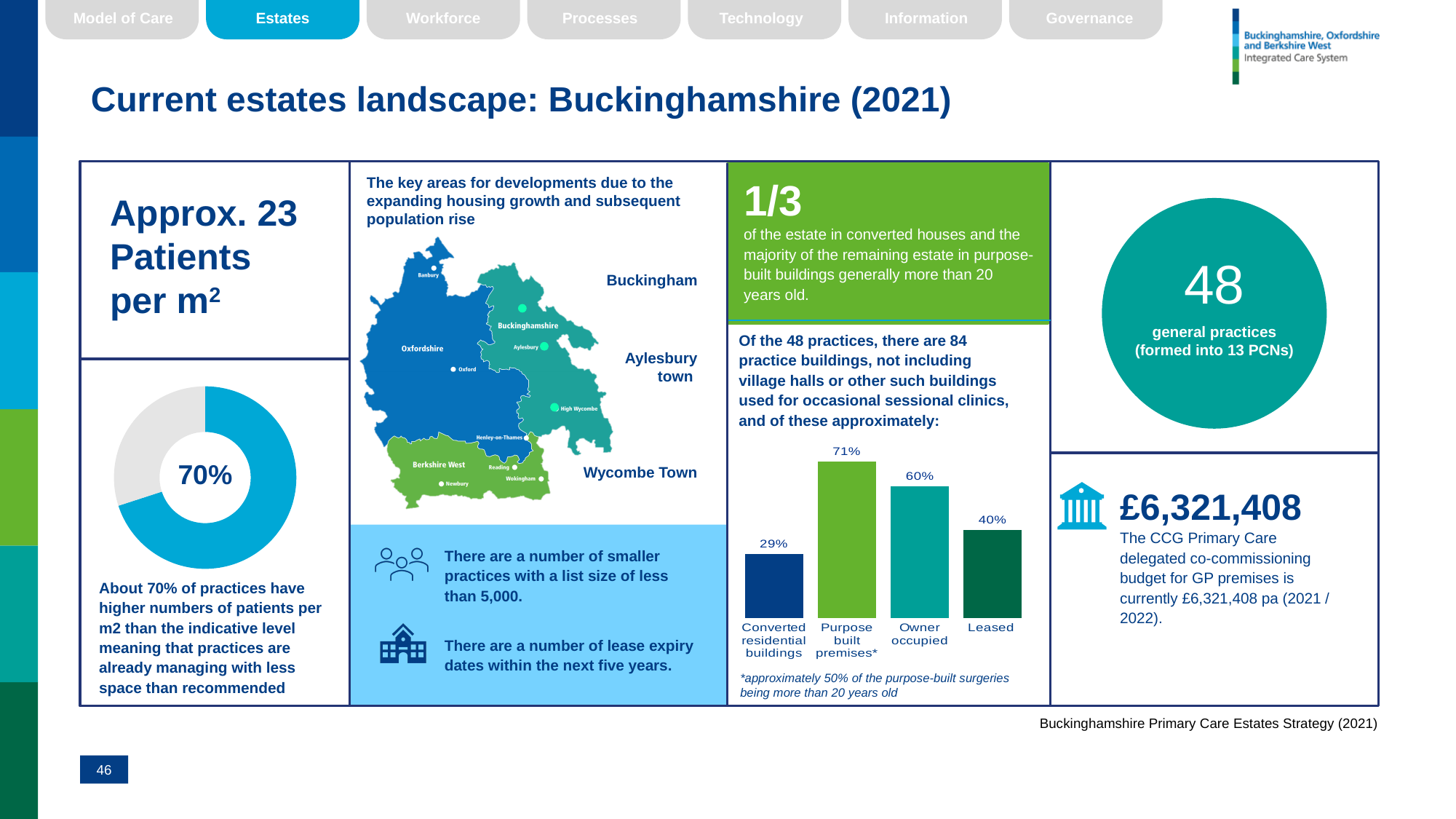
In the bar chart of practice buildings, which category has the lowest value? Converted residential buildings In the bar chart of practice buildings, which is larger, Owner occupied or Leased? Owner occupied How many categories are shown in the bar chart of practice buildings? 4 What kind of chart is used to show the practice building percentages (Converted residential buildings, Purpose built premises, Owner occupied, Leased)? Bar chart In the bar chart of practice buildings, what is the difference between Purpose built premises and Converted residential buildings? 42% In the bar chart of practice buildings, what is the value for Leased? 40% In the bar chart of practice buildings, which category has the highest value? Purpose built premises What percentage is shown in the centre of the donut chart on the left of the slide? 70% In the bar chart of practice buildings, what is the value for Purpose built premises? 71% In the bar chart of practice buildings, what is the value for Converted residential buildings? 29% In the bar chart of practice buildings, what is the difference between Owner occupied and Leased? 20% What kind of chart is used on the left of the slide to show the 70% figure? Donut chart